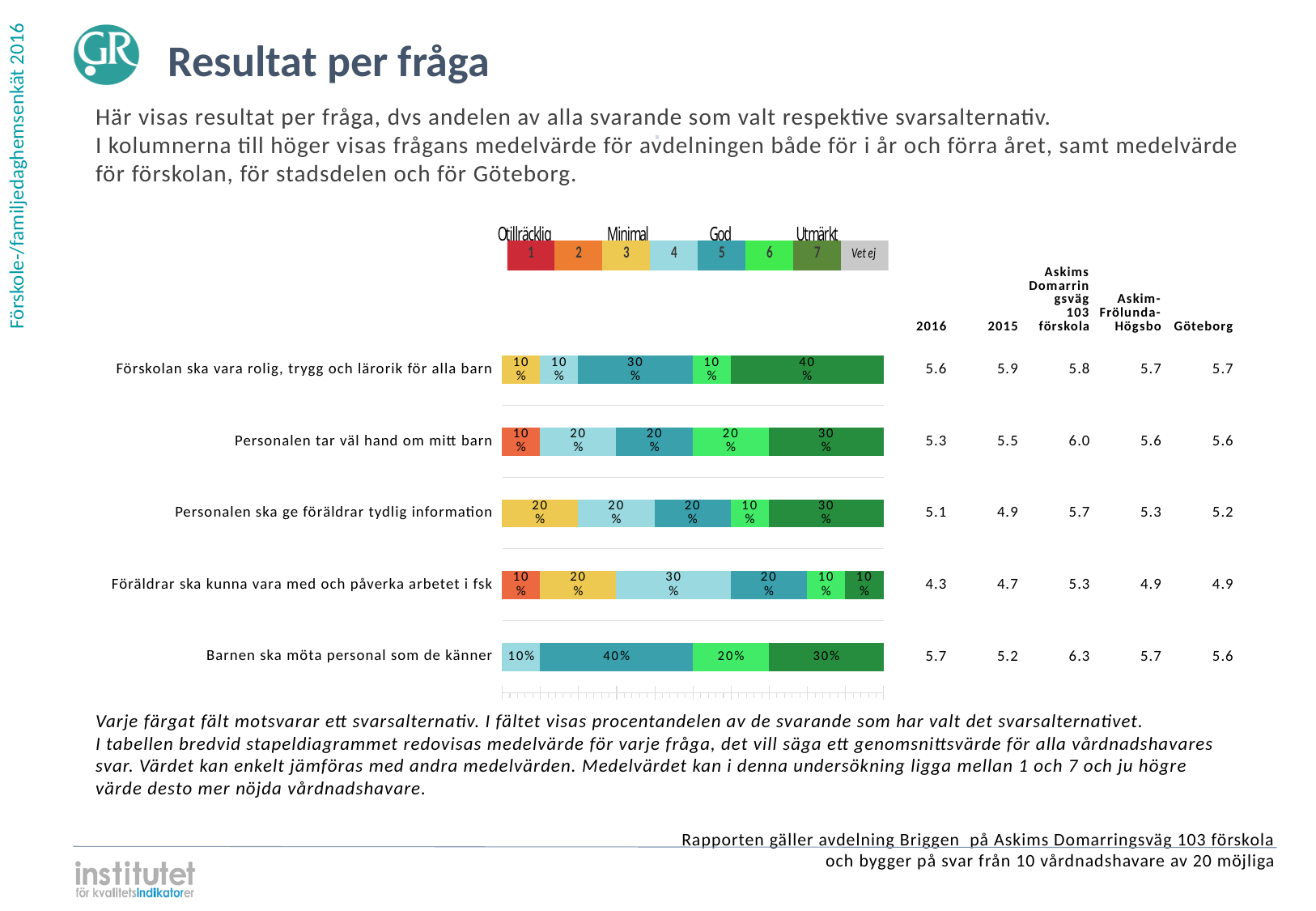
What share of respondents chose answer 7 (Utmärkt, dark green) for 'Förskolan ska vara rolig, trygg och lärorik för alla barn'? 40% How many answer alternatives does the legend above the chart list? 8 What share of respondents chose answer 4 (light blue) for 'Föräldrar ska kunna vara med och påverka arbetet i fsk'? 30% What is the difference between the share for answer 7 and the share for answer 6 in 'Personalen ska ge föräldrar tydlig information'? 20% Which answer alternative has the largest share for 'Förskolan ska vara rolig, trygg och lärorik för alla barn'? 7 (Utmärkt) What is the total of all segments in the bar for 'Personalen tar väl hand om mitt barn'? 100% What share of respondents chose answer 5 (teal) for 'Barnen ska möta personal som de känner'? 40% What share of respondents chose answer 2 (orange) for 'Personalen tar väl hand om mitt barn'? 10% How many questions (categories) are shown in the bar chart? 5 For 'Barnen ska möta personal som de känner', which is larger: the share for answer 6 (bright green) or the share for answer 7 (dark green)? Answer 7 (dark green) Which label in the legend corresponds to answer alternative 1? Otillräcklig What kind of chart is used to show the results per question? Stacked bar chart